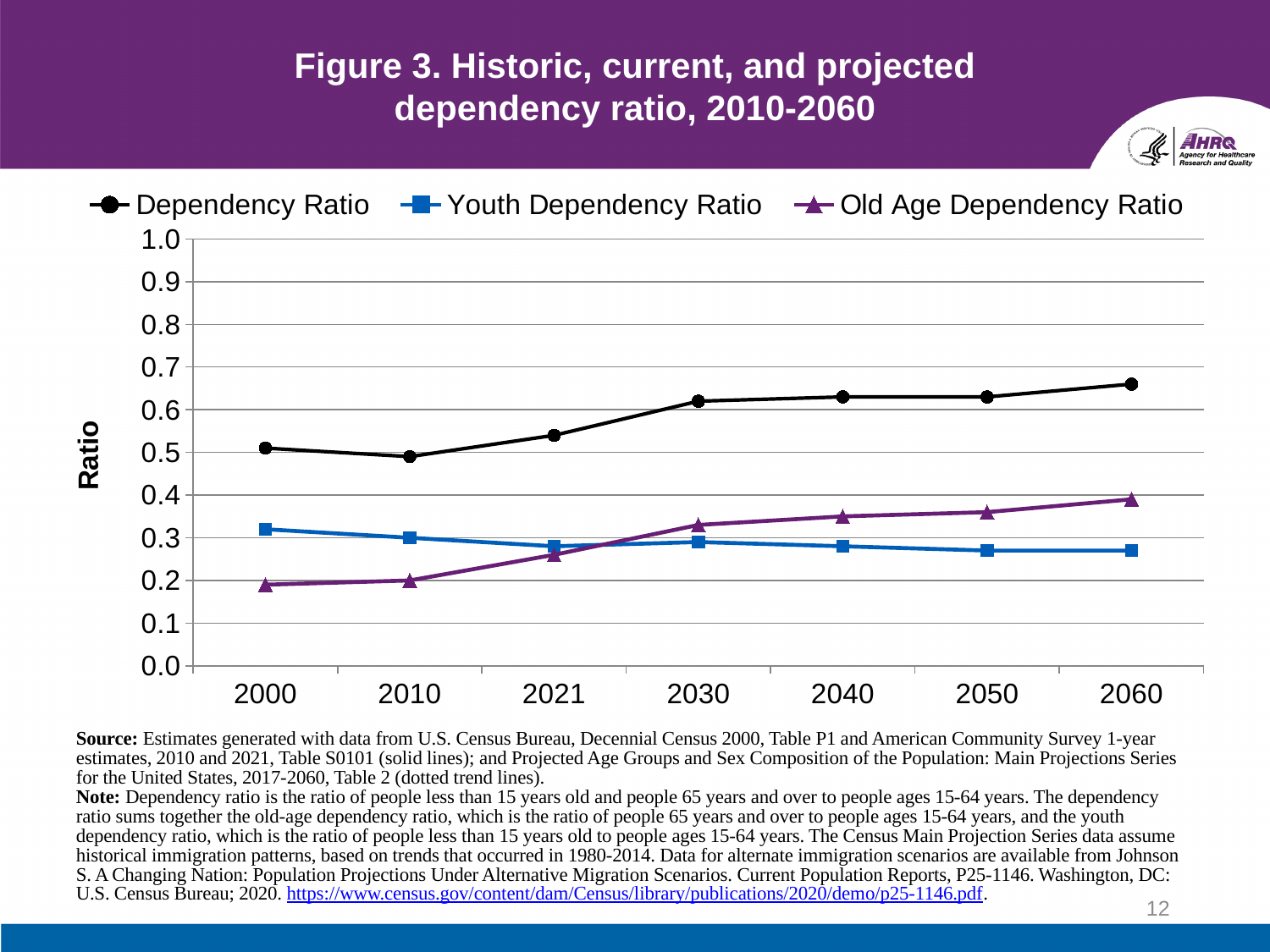
How many years are plotted along the x axis? 7 What kind of chart is shown on the slide? line chart In which year is the Youth Dependency Ratio highest? 2000 Does the Old Age Dependency Ratio rise or fall from 2000 to 2060? rise Is the Dependency Ratio value for 2021 greater or less than 0.5? greater In 2000, which is larger: the Youth Dependency Ratio or the Old Age Dependency Ratio? Youth Dependency Ratio Is the Dependency Ratio value for 2060 greater or less than 0.6? greater Is the Old Age Dependency Ratio value for 2060 greater or less than 0.3? greater What is the label on the y axis? Ratio In which year is the Old Age Dependency Ratio highest? 2060 How many series does the legend list? 3